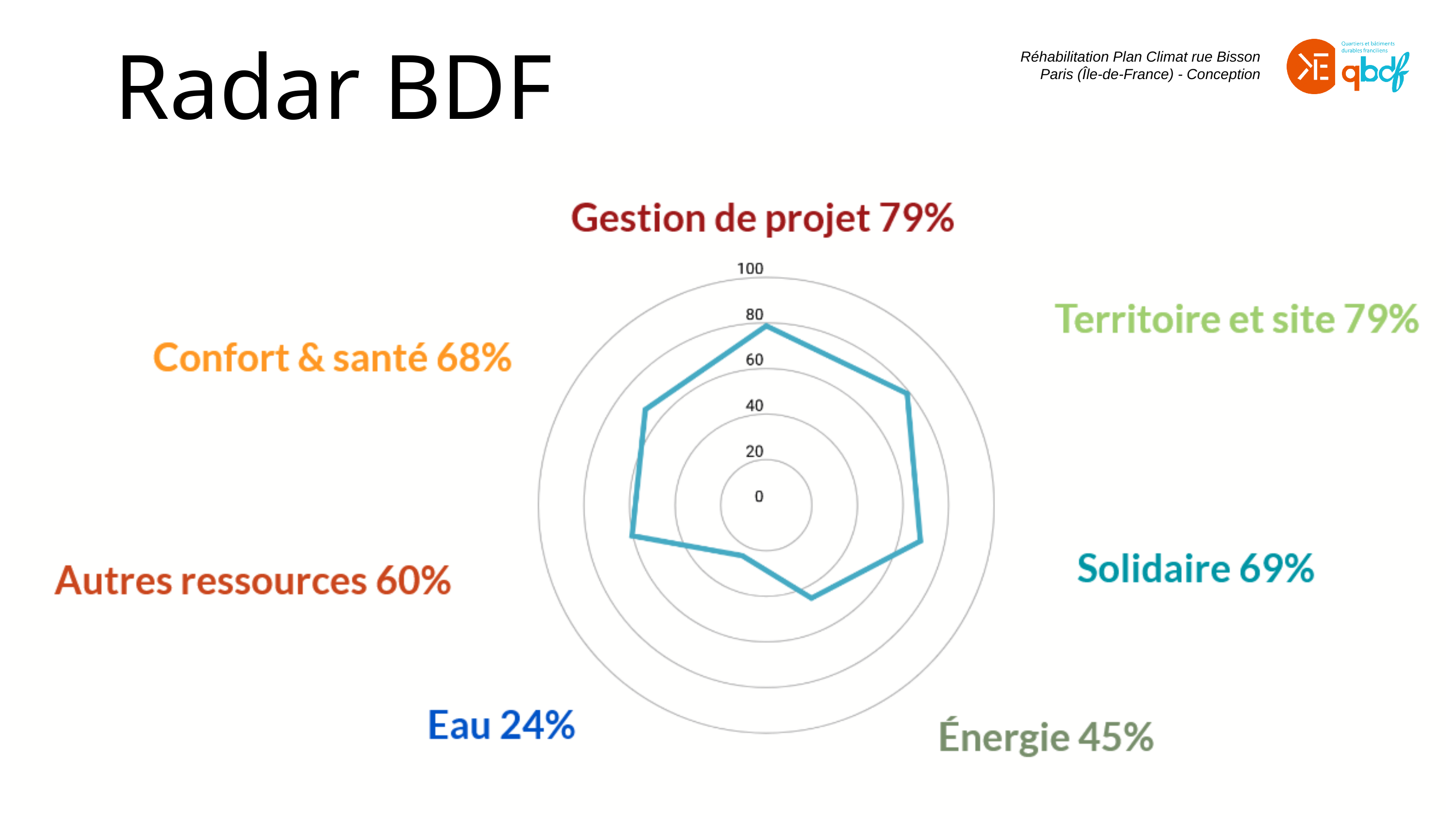
What is the value for Eau? 24% Which is larger, the value for Énergie or the value for Autres ressources? Autres ressources What is the value for Énergie? 45% What is the difference between the values for Gestion de projet and Eau? 55 percentage points What is the value for Gestion de projet? 79% What is the value for Autres ressources? 60% What kind of chart is shown on the slide? Radar chart What is the value for Solidaire? 69% How many categories does the radar chart have? 7 What is the title of the slide containing the radar chart? Radar BDF Is the value for Énergie greater or less than 60? less Which category has the lowest value? Eau